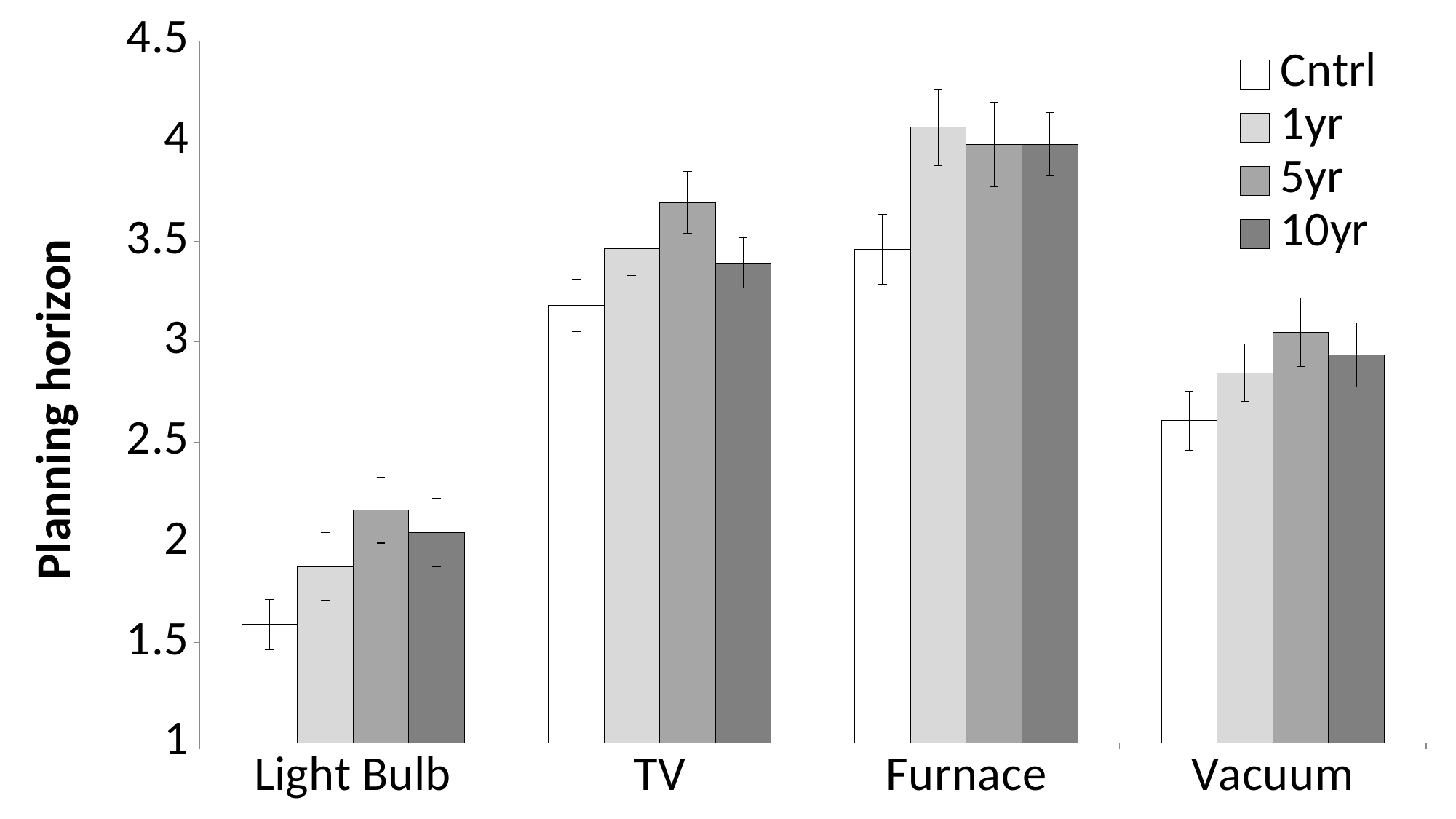
What is the title of the y axis? Planning horizon Which product category has the lowest Cntrl value? Light Bulb How many product categories are shown on the x axis? 4 Is the Cntrl value for Light Bulb greater or less than 2? less How many series does the legend list? 4 Is the Cntrl value for TV greater or less than 3? greater For TV, which series has the highest planning horizon? 5yr Is the 1yr value for Furnace greater or less than 4? greater What are the four legend entries? Cntrl, 1yr, 5yr, 10yr What kind of chart is shown on the slide? bar chart Which product category has the highest Cntrl value? Furnace